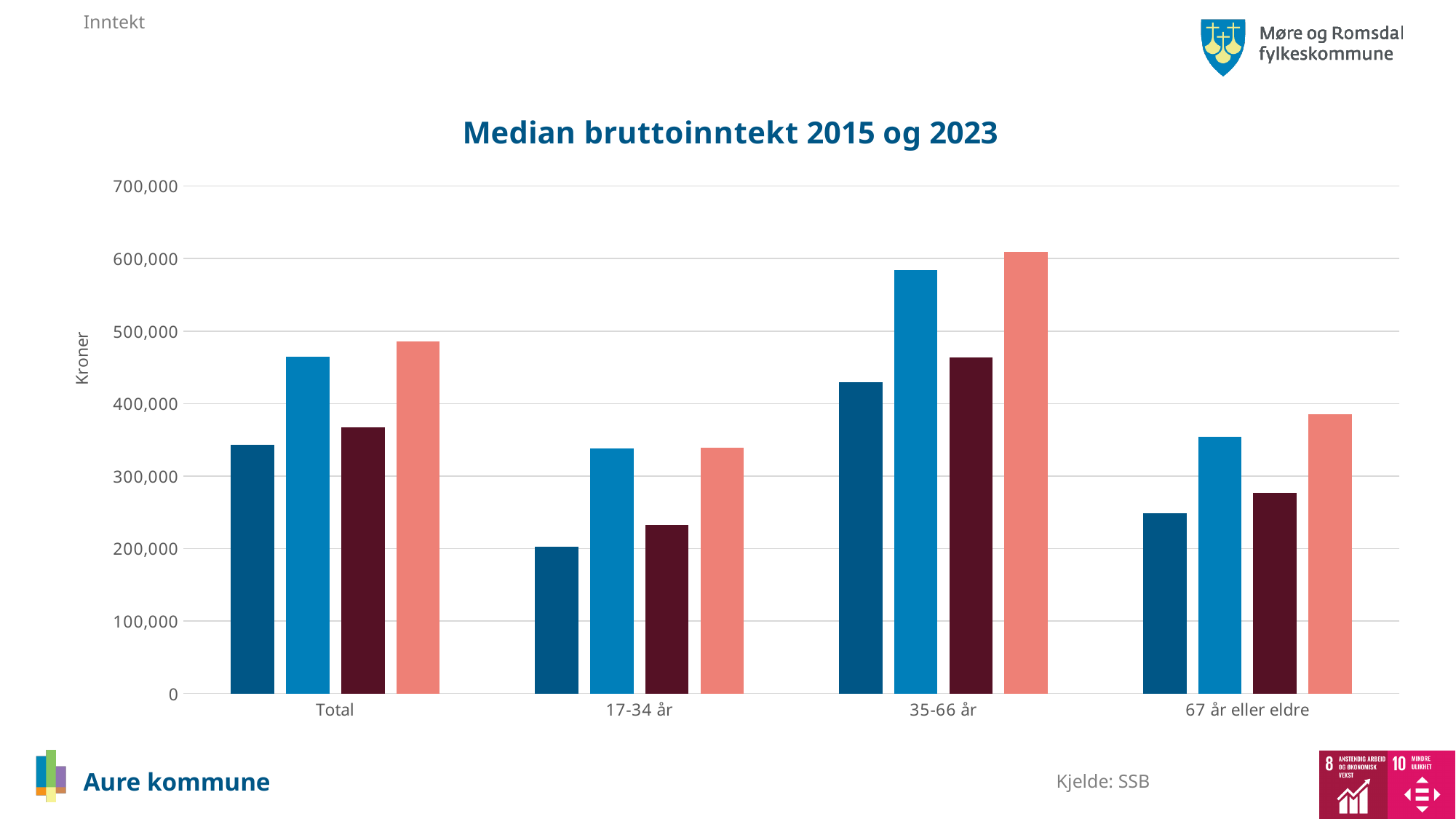
In the 35-66 år category, which bar is taller: the salmon bar or the light blue bar? the salmon bar What is the title of the chart? Median bruttoinntekt 2015 og 2023 What is the label on the vertical axis of the chart? Kroner What kind of chart is shown on the slide? bar chart How many age categories are shown along the x axis? 4 Which category has the tallest bars in the chart? 35-66 år Is the value of the light blue bar for 35-66 år greater or less than 600,000? less Is the value of the dark blue bar for 67 år eller eldre greater or less than 300,000? less Is the value of the dark red bar for 17-34 år greater or less than 300,000? less Which category has the shortest dark blue bar? 17-34 år